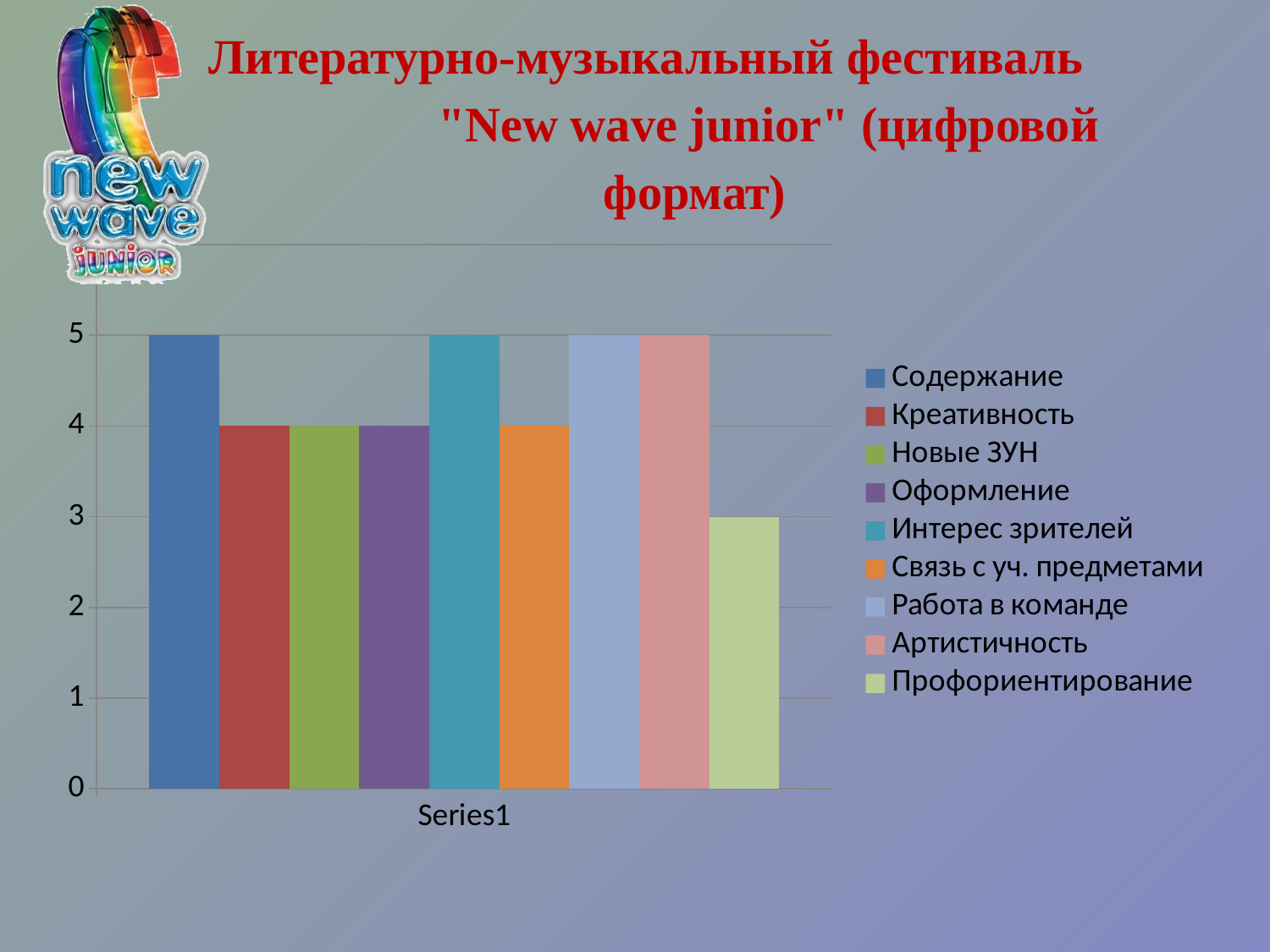
Is the value for Новые ЗУН greater or less than 3? greater How many entries does the chart legend list? 9 Which is larger, the value for Интерес зрителей or the value for Оформление? Интерес зрителей What is the value for Содержание? 5 What is the category label shown on the x axis? Series1 What is the difference between the value for Артистичность and the value for Профориентирование? 2 What is the value for Креативность? 4 What is the value for Связь с уч. предметами? 4 What is the value for Профориентирование? 3 Which legend entry has the lowest value? Профориентирование What is the highest value shown on the vertical axis? 5 What kind of chart is shown on the slide? bar chart